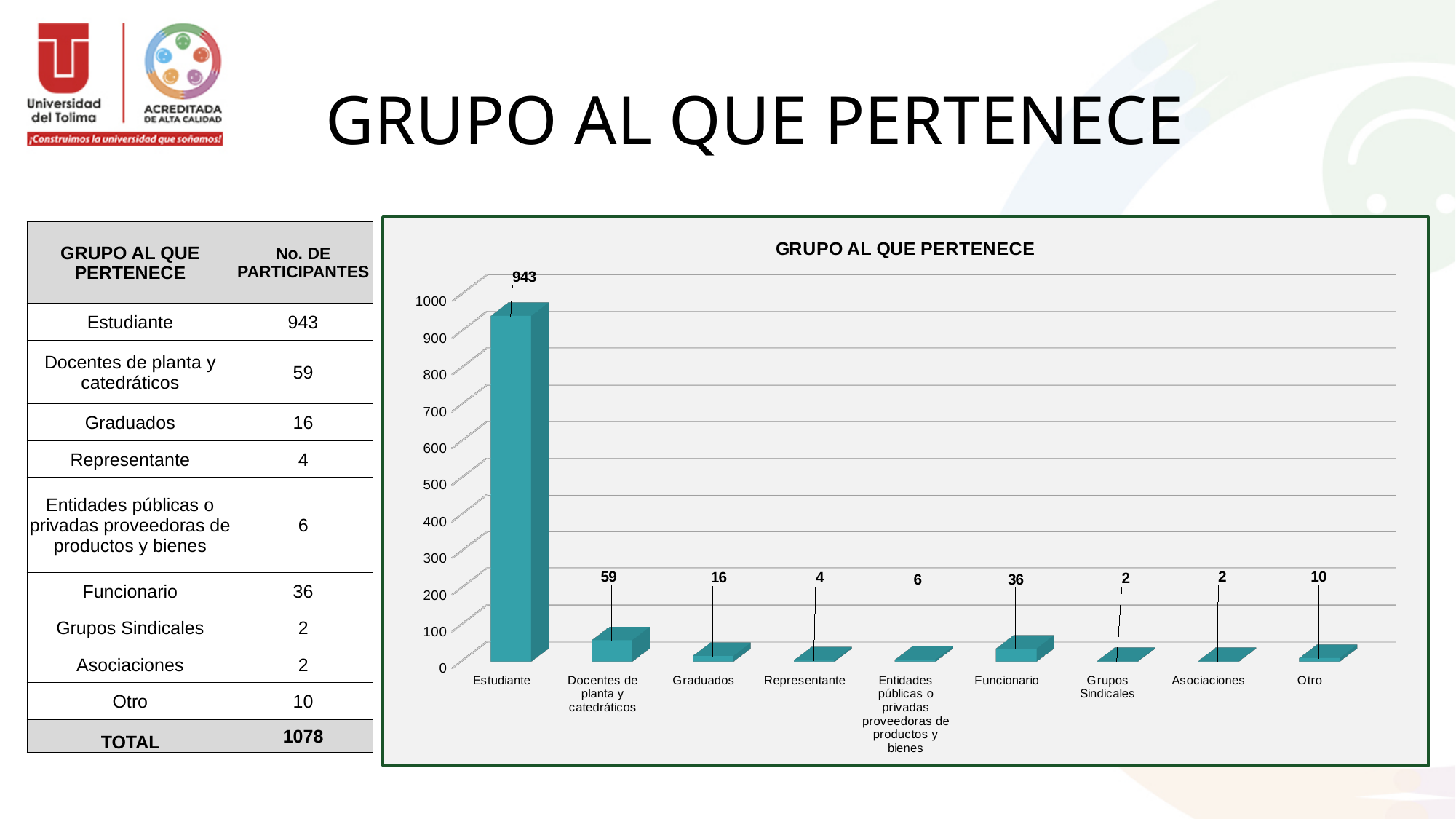
Is the value for Estudiante greater or less than 900? greater Which category has the highest value? Estudiante What kind of chart is shown? bar chart How many categories are shown on the x axis? 9 What is the title of the chart? GRUPO AL QUE PERTENECE Which is larger, the value for Graduados or the value for Otro? Graduados What is the value for Docentes de planta y catedráticos? 59 What is the difference between the values for Funcionario and Graduados? 20 What is the value for Estudiante? 943 What is the value for Funcionario? 36 What is the value for Otro? 10 What is the difference between the values for Estudiante and Docentes de planta y catedráticos? 884